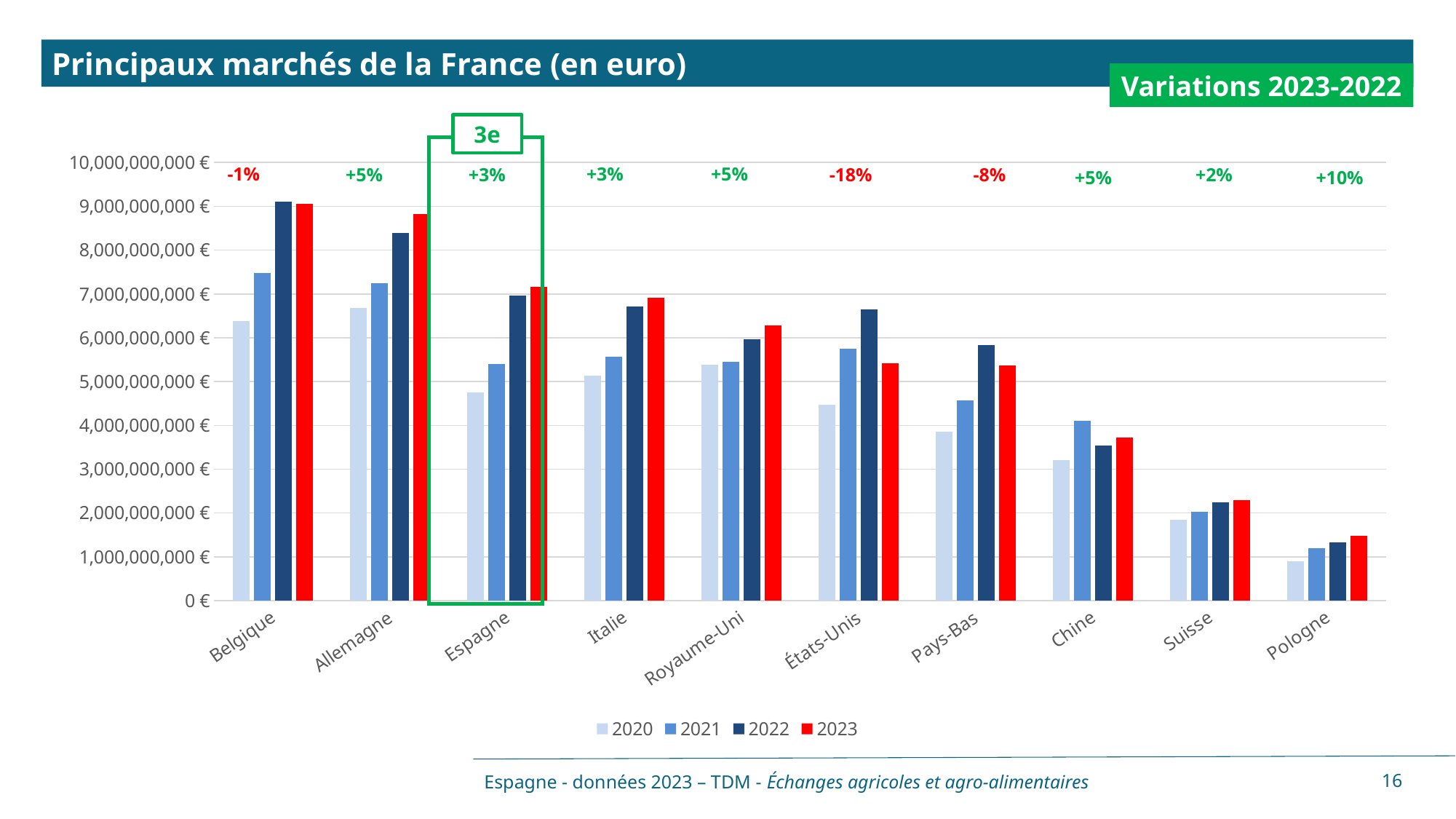
Which country has the lowest 2023 value? Pologne Is the 2023 value for Belgique greater or less than 8,000,000,000 €? greater What is the 2023-2022 variation shown for Pays-Bas? -8% What kind of chart is shown on the slide? bar chart What is the 2023-2022 variation shown for Pologne? +10% What is the 2023-2022 variation shown for États-Unis? -18% Which country is highlighted with the label "3e" on the chart? Espagne Is the 2023 value for Chine greater or less than 4,000,000,000 €? less How many series does the legend list? 4 How many countries are shown on the x axis of the chart? 10 Which country has the highest 2022 value? Belgique Which is larger, the 2023 value for Italie or the 2023 value for Royaume-Uni? Italie